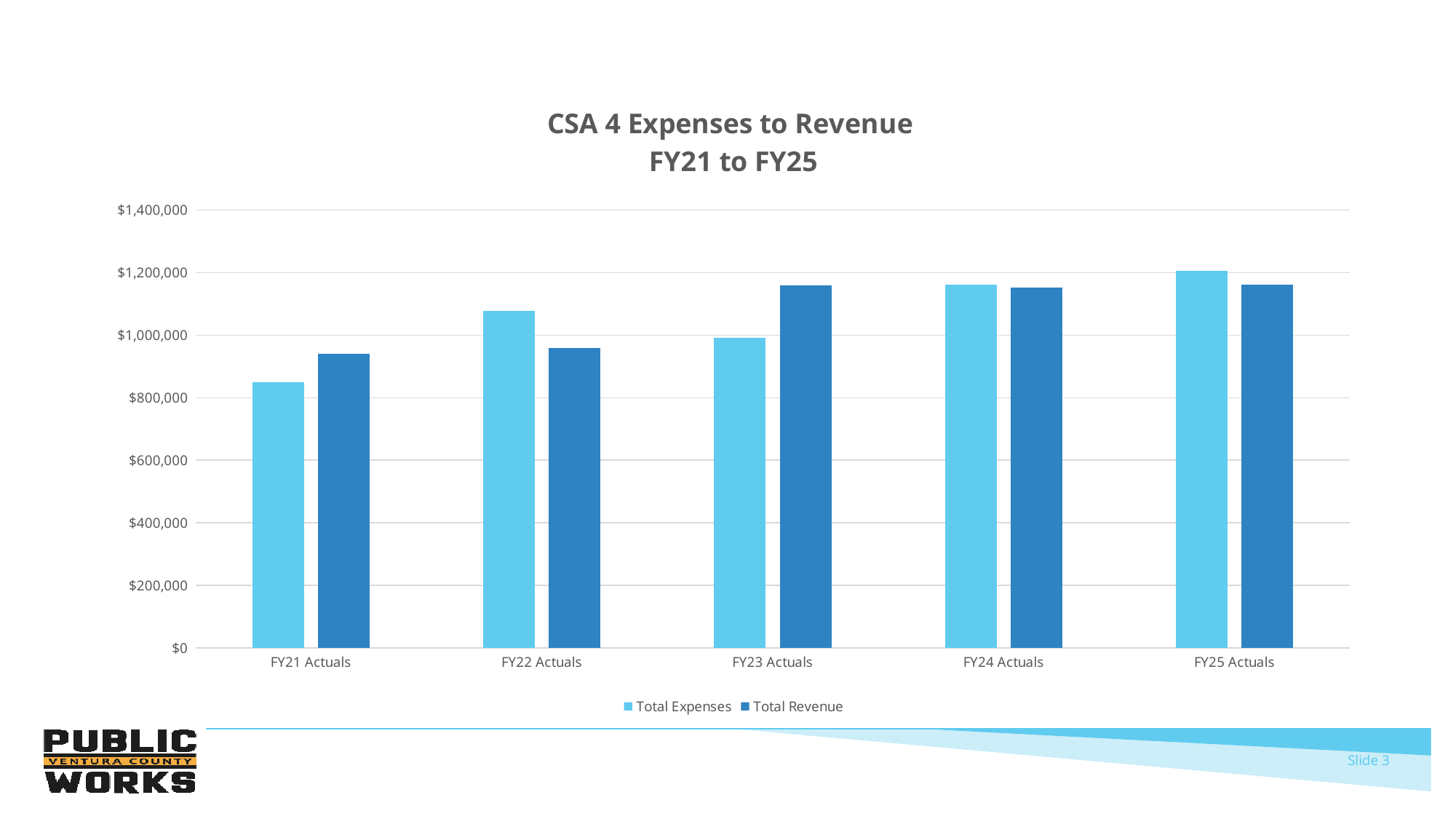
Is the Total Expenses value for FY22 Actuals greater or less than $1,000,000? greater In FY22 Actuals, which is larger: Total Expenses or Total Revenue? Total Expenses In FY23 Actuals, which is larger: Total Expenses or Total Revenue? Total Revenue Which fiscal year has the lowest Total Expenses? FY21 Actuals How many fiscal year categories are shown on the x axis? 5 What type of chart is shown on the slide? Bar chart Which fiscal year has the lowest Total Revenue? FY21 Actuals How many series does the legend list? 2 What is the title of the chart? CSA 4 Expenses to Revenue FY21 to FY25 Which fiscal year has the highest Total Expenses? FY25 Actuals Is the Total Expenses value for FY21 Actuals greater or less than $1,000,000? less Is the Total Revenue value for FY23 Actuals greater or less than $1,000,000? greater